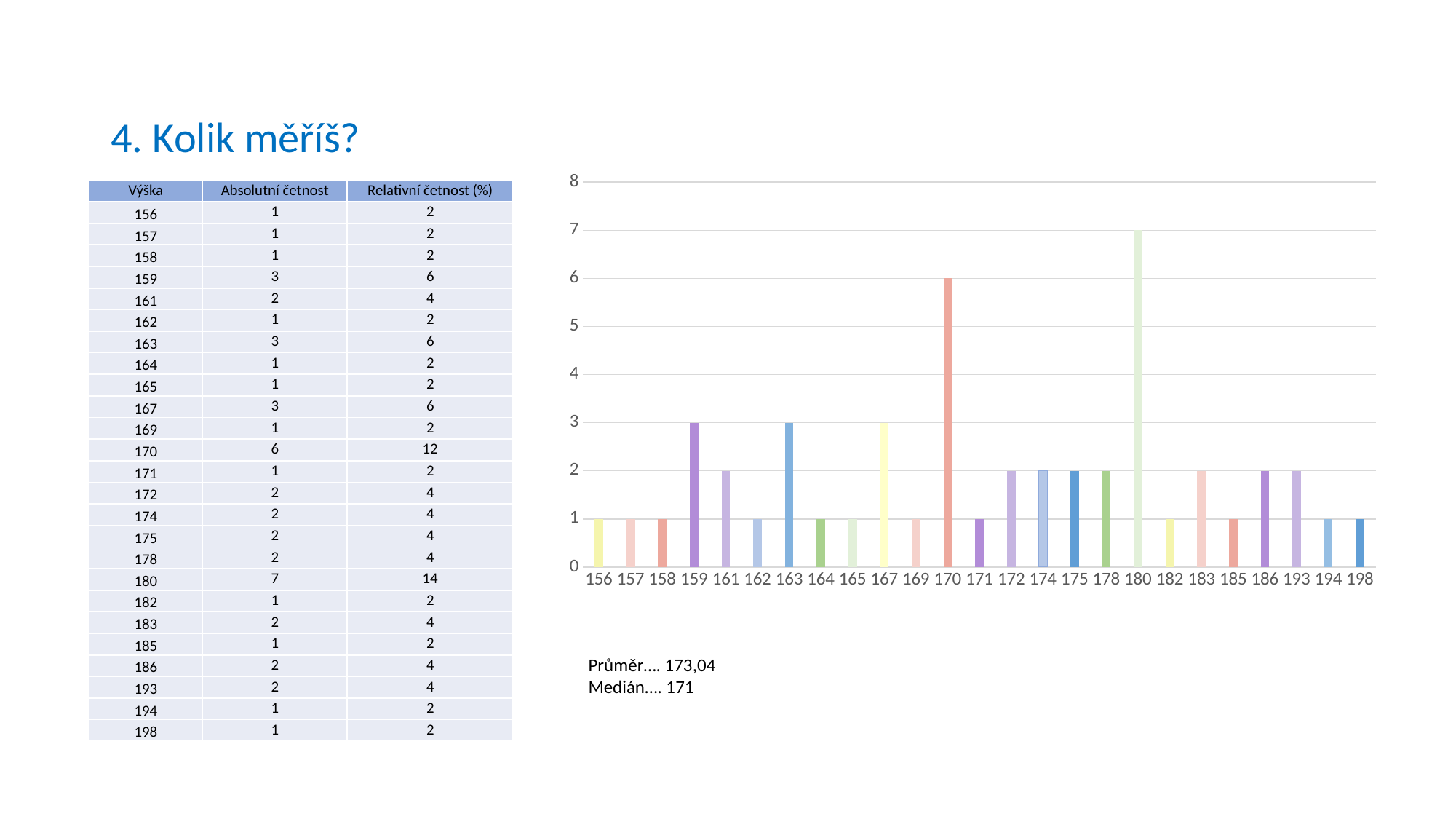
What is the value of the bar for height 180? 7 What is the value of the bar for height 174? 2 Which is larger, the bar for 159 or the bar for 161? 159 Is the value for 170 greater or less than 5? greater What is the difference between the bar for 170 and the bar for 167? 3 What is the difference between the bar for 180 and the bar for 170? 1 What is the value of the bar for height 170? 6 What type of chart is shown on the slide? bar chart How many height categories are shown on the x axis of the chart? 25 Which height category has the highest bar in the chart? 180 What is the value of the bar for height 159? 3 What is the highest value shown on the chart's vertical axis? 8